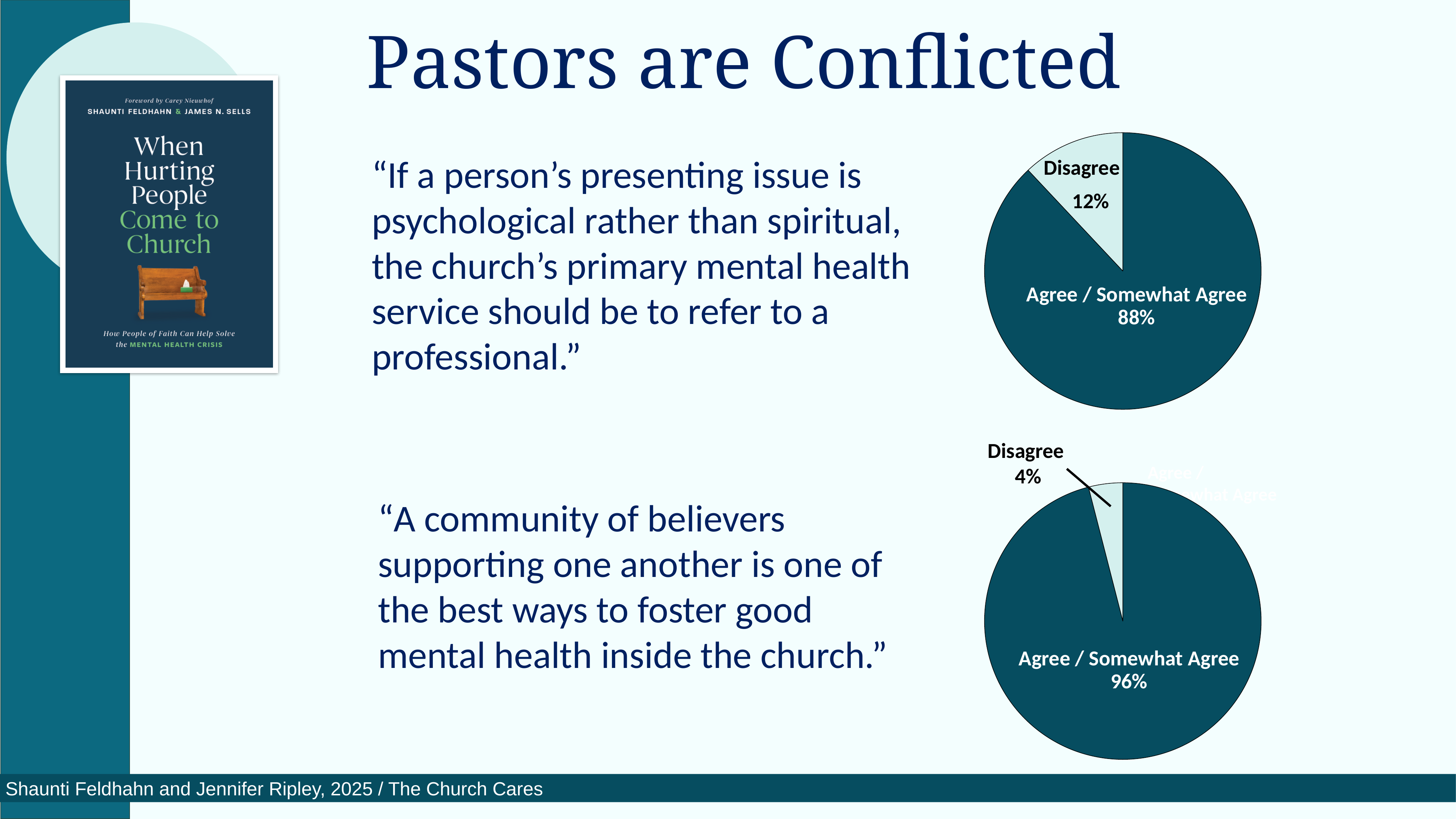
In the top pie chart, what percentage is labelled Agree / Somewhat Agree? 88% In the bottom pie chart, what percentage is labelled Agree / Somewhat Agree? 96% In the bottom pie chart, what is the difference between the Agree / Somewhat Agree share and the Disagree share? 92% In the top pie chart, what is the difference between the Agree / Somewhat Agree share and the Disagree share? 76% In the top pie chart, what percentage is labelled Disagree? 12% In the bottom pie chart, what percentage is labelled Disagree? 4% Which chart has the larger Disagree share, the top pie chart or the bottom pie chart? The top pie chart In the bottom pie chart, which slice is the smallest? Disagree What type of chart is the bottom chart on the right of the slide? Pie chart In the top pie chart, which slice is the largest? Agree / Somewhat Agree How many pie charts are shown on the slide? 2 How many slices does the top pie chart have? 2